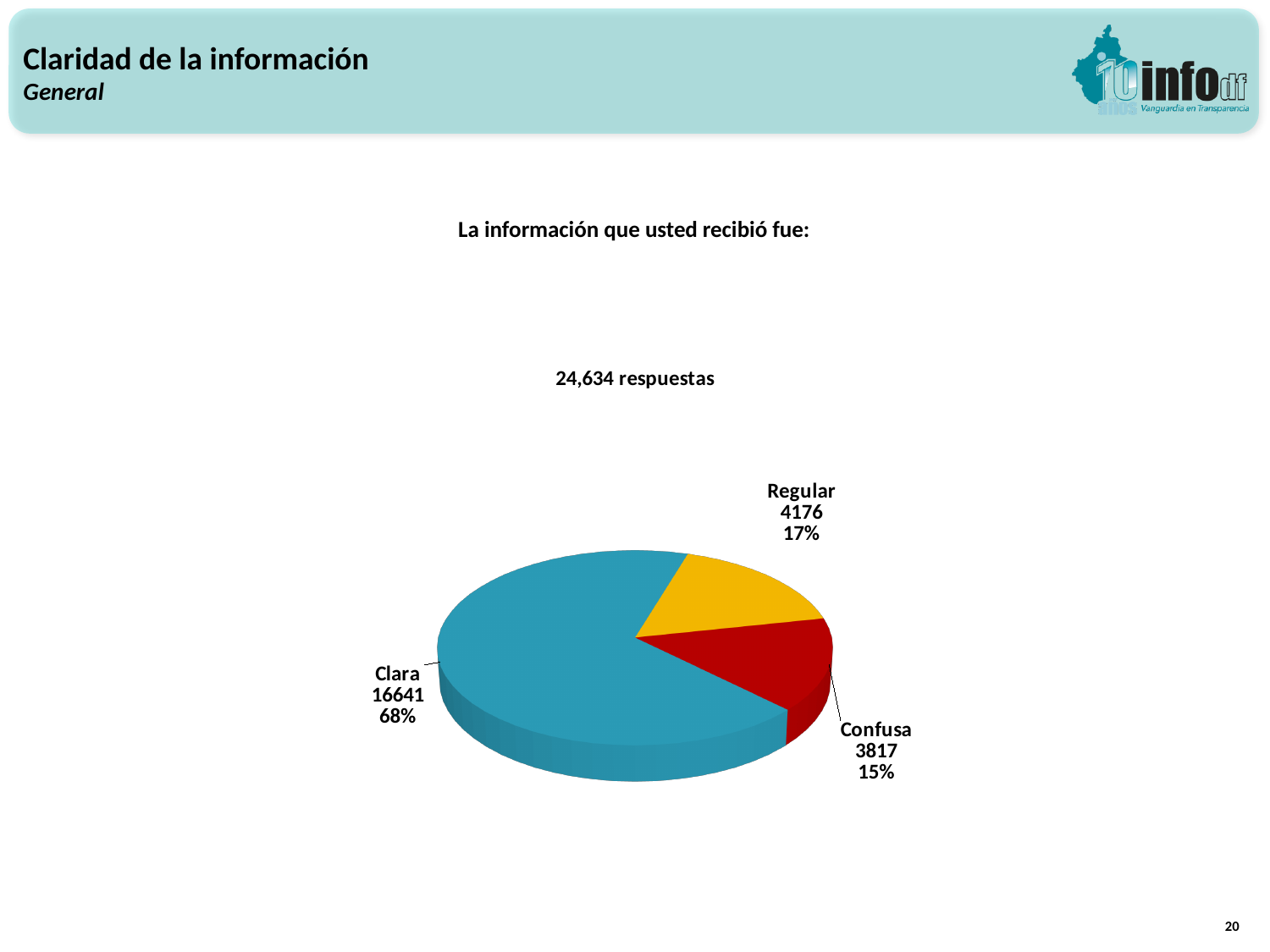
How many responses does the chart report for "Regular"? 4176 Which category has the smallest slice of the pie? Confusa Which has more responses, "Regular" or "Confusa"? Regular What is the difference in responses between "Clara" and "Regular"? 12465 How many responses does the chart report for "Clara"? 16641 Which category has the largest slice of the pie? Clara What share of the pie does the "Clara" slice represent? 68% What share of the pie does the "Confusa" slice represent? 15% How many responses does the chart report for "Confusa"? 3817 How many categories are shown in the pie chart? 3 What kind of chart is shown on the slide? pie chart What total number of responses is stated above the chart? 24,634 respuestas